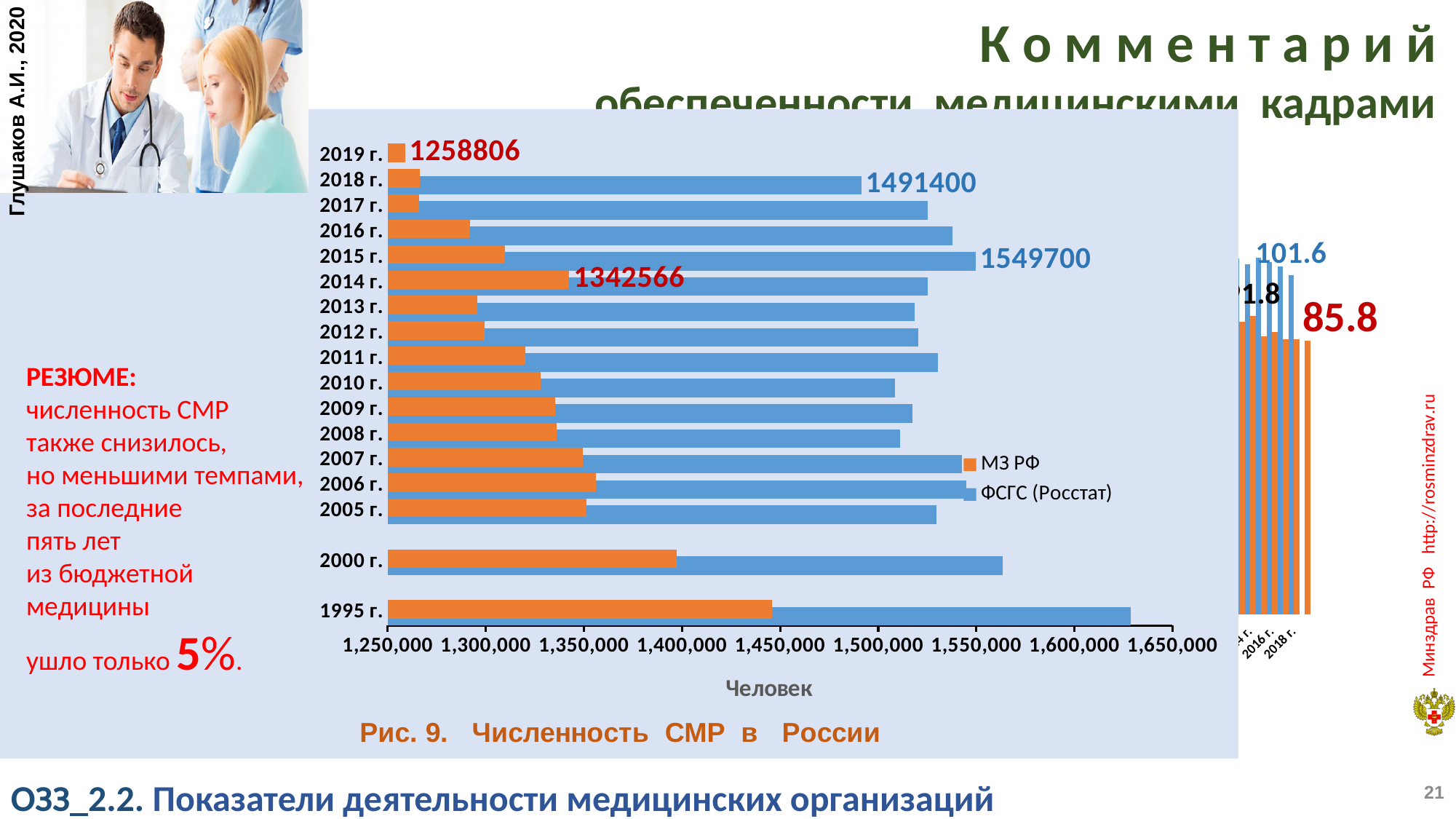
In the chart 'Рис. 9. Численность СМР в России', what is the МЗ РФ value for 2019 г.? 1258806 In the chart 'Рис. 9. Численность СМР в России', by how much does the ФСГС (Росстат) value for 2015 г. exceed that for 2018 г.? 58300 What type of chart is 'Рис. 9. Численность СМР в России'? Bar chart In the chart 'Рис. 9. Численность СМР в России', by how much does the МЗ РФ value for 2014 г. exceed that for 2019 г.? 83760 In the chart 'Рис. 9. Численность СМР в России', what is the ФСГС (Росстат) value for 2015 г.? 1549700 In the chart 'Рис. 9. Численность СМР в России', which year has the longest ФСГС (Росстат) bar? 1995 г. In the chart 'Рис. 9. Численность СМР в России', what is the ФСГС (Росстат) value for 2018 г.? 1491400 In the chart 'Рис. 9. Численность СМР в России', what is the МЗ РФ value for 2014 г.? 1342566 In the chart 'Рис. 9. Численность СМР в России', is the ФСГС (Росстат) value for 1995 г. greater or less than 1,600,000? greater In the chart 'Рис. 9. Численность СМР в России', how many series does the legend list? 2 In the chart 'Рис. 9. Численность СМР в России', which year has the shortest МЗ РФ bar? 2019 г. In the chart 'Рис. 9. Численность СМР в России', how many years are shown on the vertical axis? 17